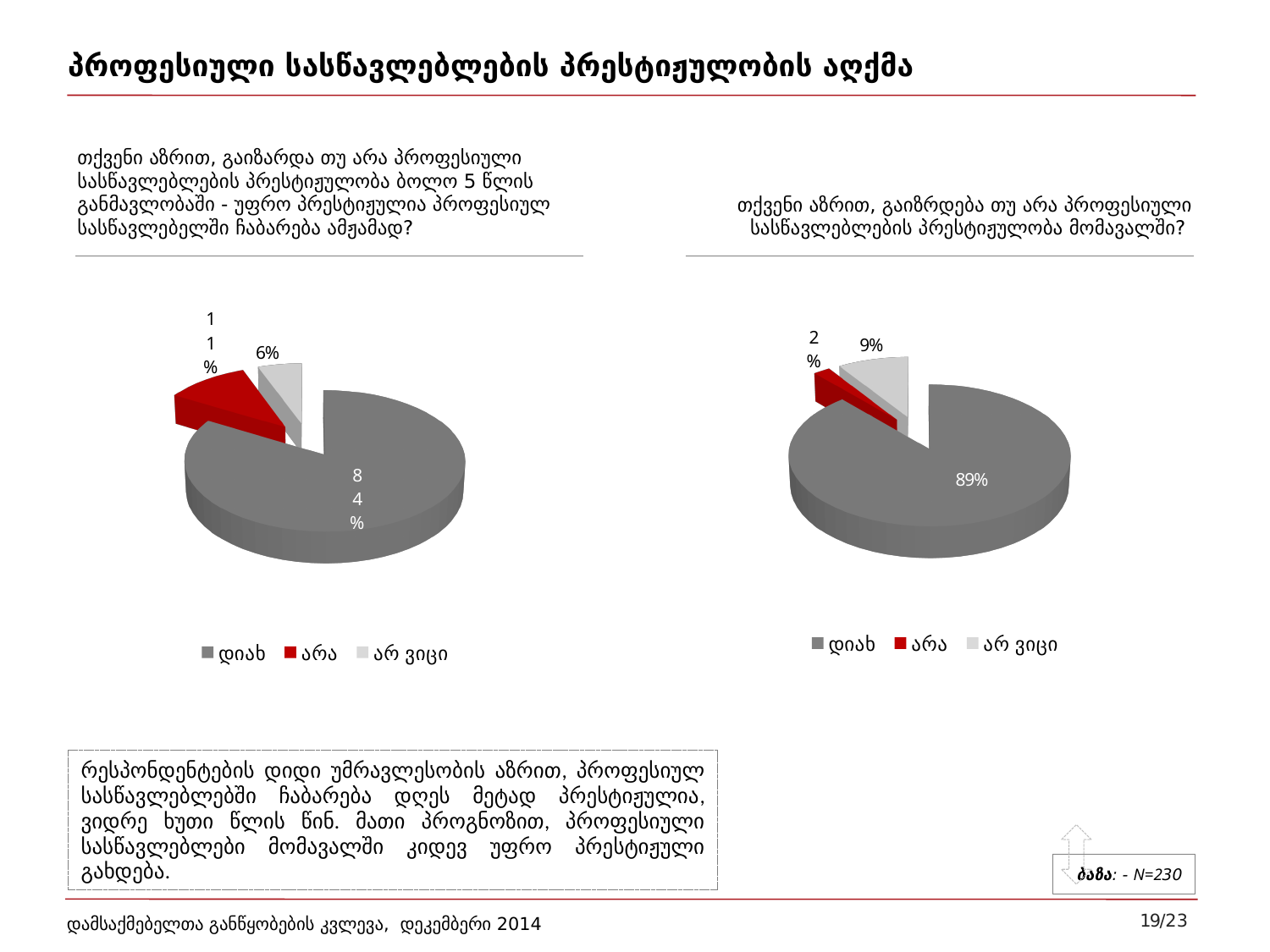
In the right pie chart, which category has the smallest share? არა Which is larger in the left pie chart: the არა slice or the არ ვიცი slice? არა In the left pie chart, what percentage is shown for the არ ვიცი slice? 6% In the left pie chart, what percentage is shown for the დიახ slice? 84% In the right pie chart, what percentage is shown for the დიახ slice? 89% In the left pie chart, which category has the largest share? დიახ How many entries does the legend of the right chart list? 3 What type of chart is used on the left side of the slide? Pie chart In the left pie chart, what percentage is shown for the არა slice? 11% In the right pie chart, what percentage is shown for the არ ვიცი slice? 9% In the right pie chart, what percentage is shown for the არა slice? 2% What is the difference between the დიახ share in the right pie chart and the დიახ share in the left pie chart? 5%